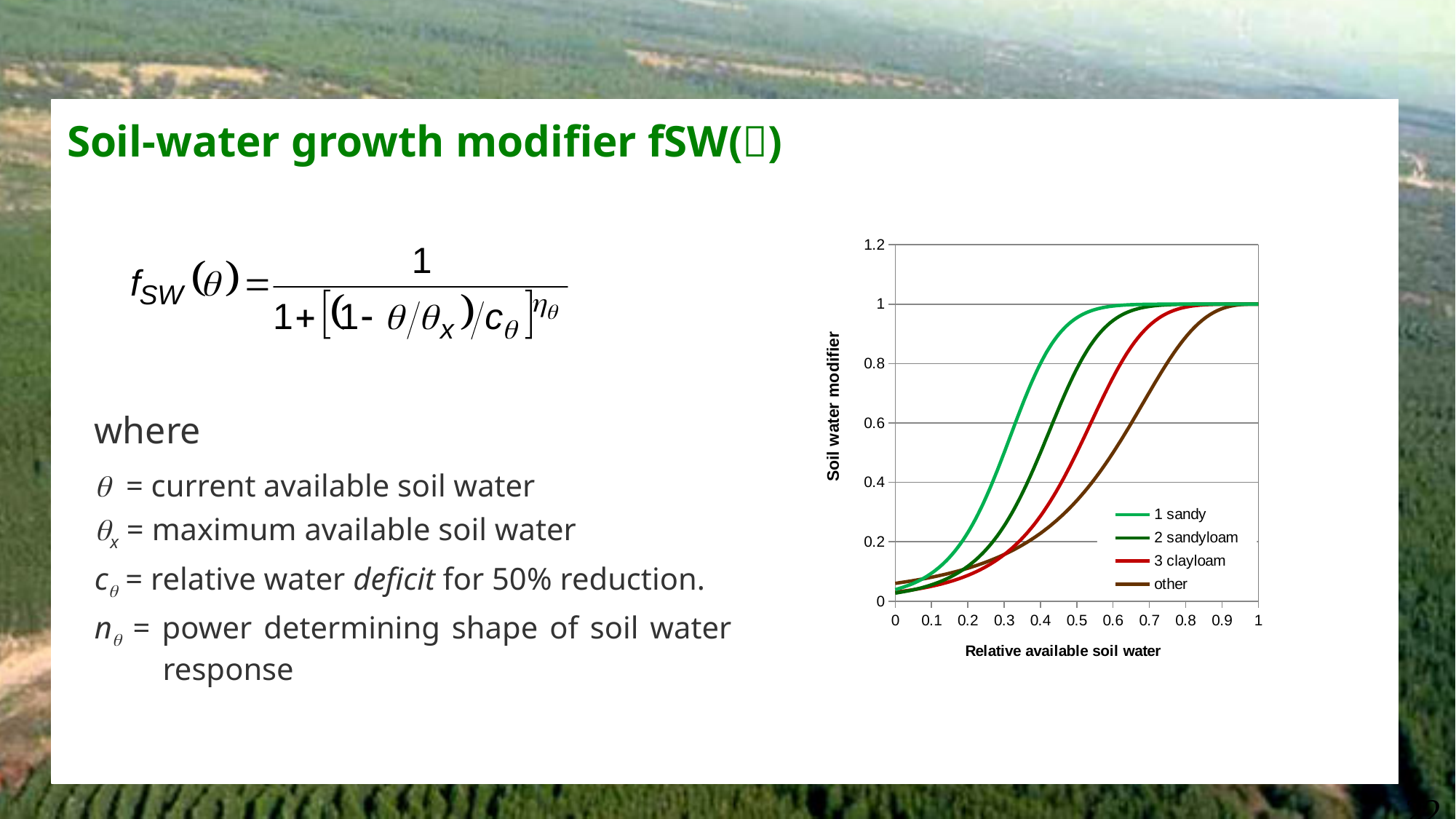
What kind of chart is shown on the slide? line chart What is the title of the chart's x axis? Relative available soil water Do the curves rise or fall as relative available soil water increases from 0 to 1? rise At a relative available soil water of 0.4, which series has the highest soil water modifier? 1 sandy At a relative available soil water of 0.4, which series has the higher soil water modifier, '1 sandy' or 'other'? 1 sandy At a relative available soil water of 0.7, is the value for the 'other' series greater or less than 0.6? greater What is the title of the chart's y axis? Soil water modifier How many series does the chart's legend list? 4 At a relative available soil water of 0.6, is the value for the '2 sandyloam' series greater or less than 0.8? greater At a relative available soil water of 0.5, is the value for the 'other' series greater or less than 0.4? less At a relative available soil water of 0.5, which series has the lowest soil water modifier? other